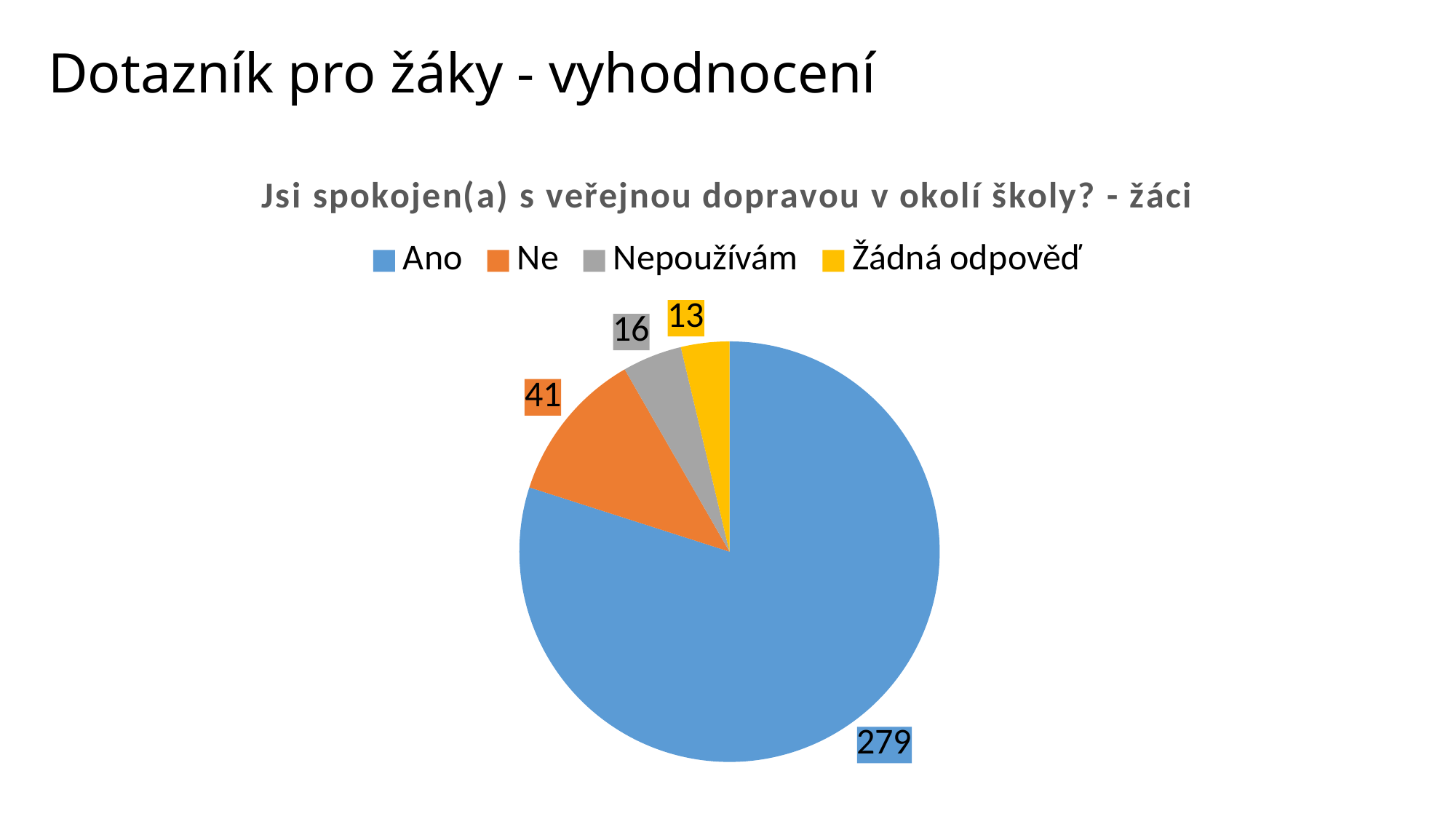
What is the total of all values shown in the pie chart? 349 What is the value for "Ano" in the pie chart? 279 What is the value for "Nepoužívám" in the pie chart? 16 What is the difference between the values for "Ano" and "Ne"? 238 How many categories does the pie chart show? 4 Which category has the largest slice in the pie chart? Ano What is the value for "Žádná odpověď" in the pie chart? 13 What is the title of the pie chart? Jsi spokojen(a) s veřejnou dopravou v okolí školy? - žáci Which is larger, the value for "Ne" or the value for "Nepoužívám"? Ne What is the value for "Ne" in the pie chart? 41 Which category has the smallest slice in the pie chart? Žádná odpověď What type of chart is shown on the slide? pie chart